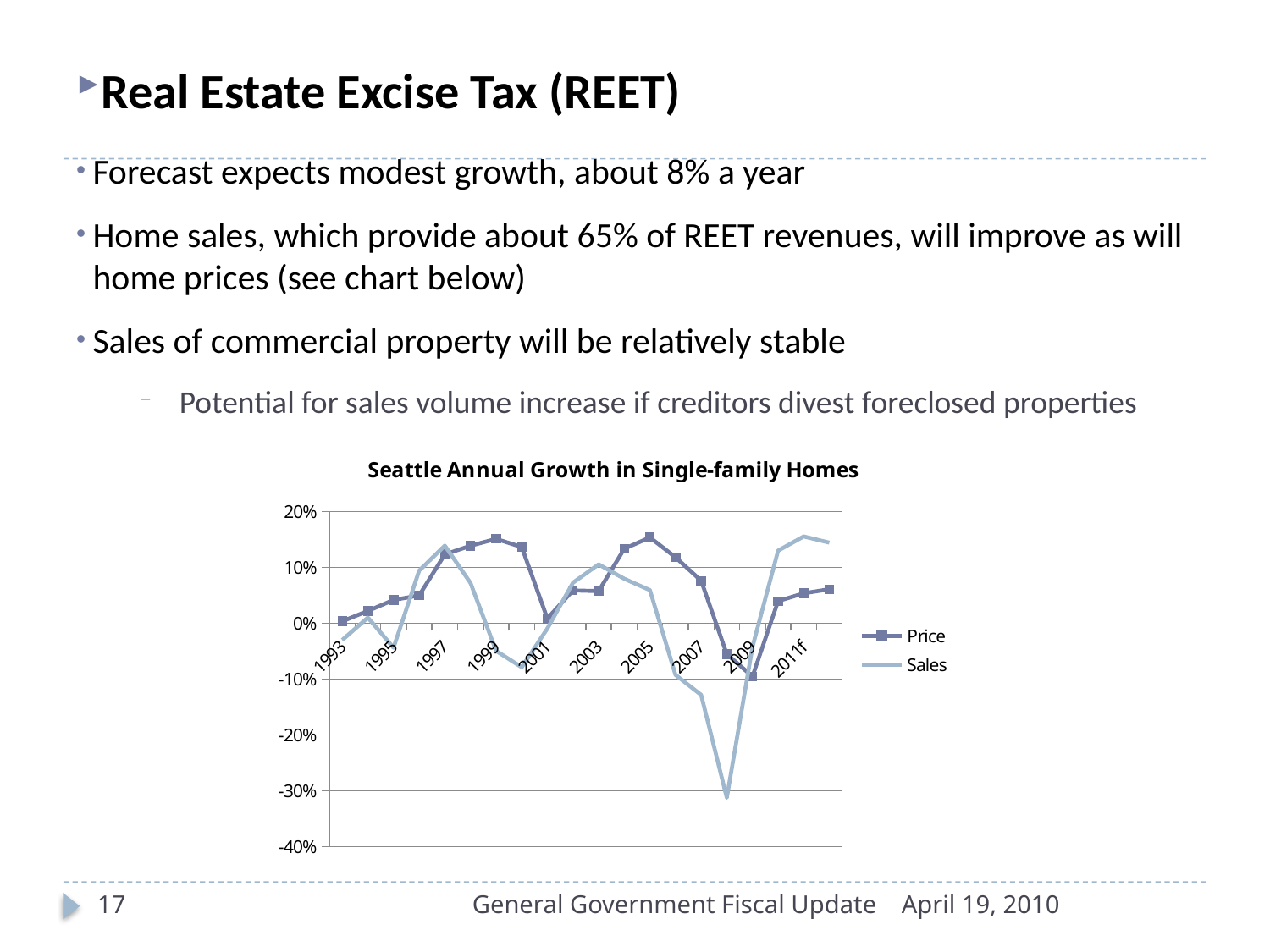
Is the Sales value for 2007 greater or less than 0%? less Does the Sales series rise or fall from 2009 to 2011f? rise How many series does the chart legend list? 2 Is the Sales value for 2011f greater or less than 10%? greater Is the Price value for 2005 greater or less than 10%? greater In 2009, which series has the lower value, Price or Sales? Price What kind of chart is shown on the slide? line chart What is the title of the chart? Seattle Annual Growth in Single-family Homes In 2005, which series has the higher value, Price or Sales? Price What are the two series named in the chart legend? Price and Sales In which year does the Sales series reach its lowest value? 2008